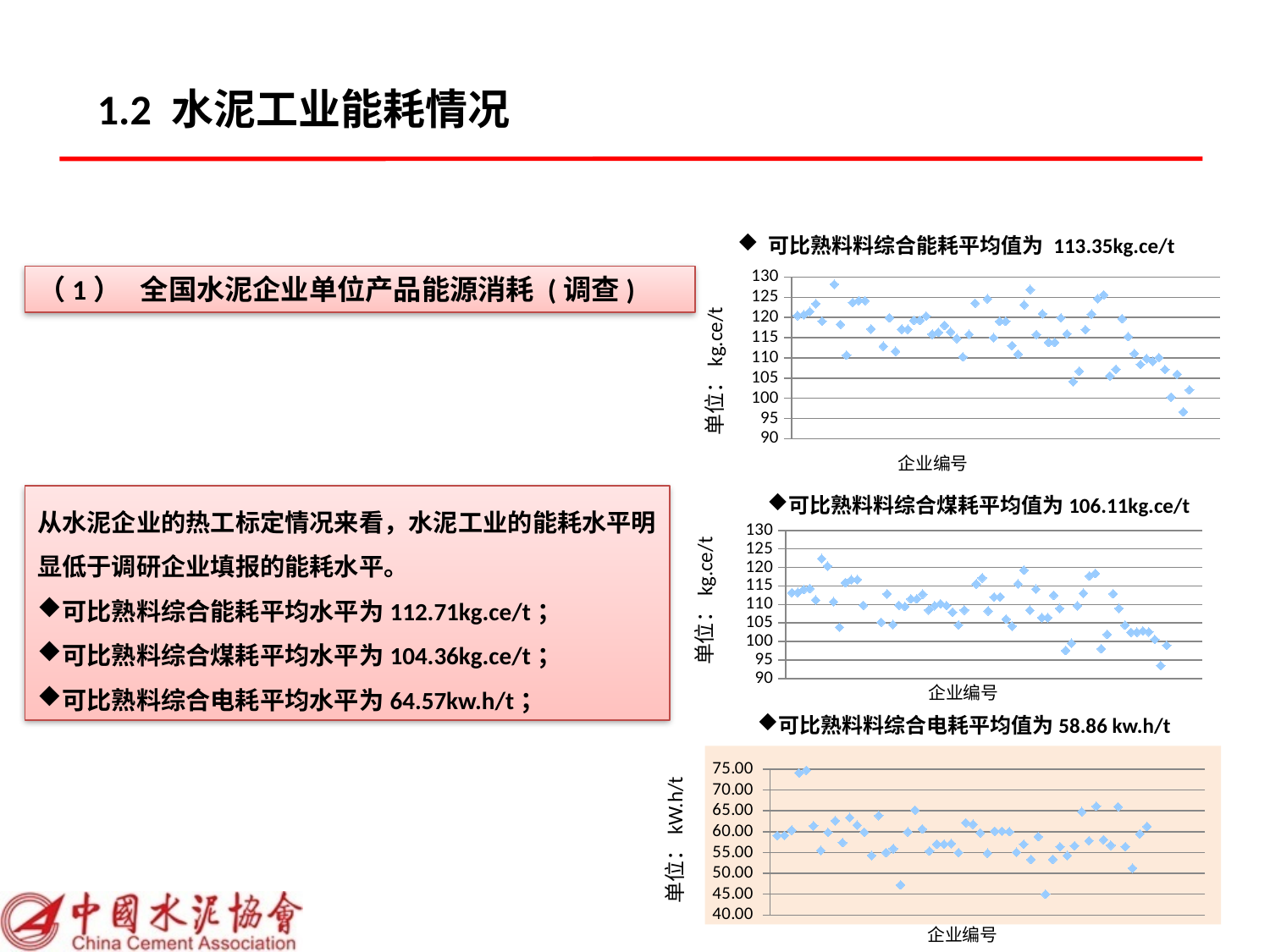
In the top chart (综合能耗), do the plotted values generally rise or fall from left to right along the x axis? fall In the bottom chart (综合电耗), is the highest plotted point greater or less than 70.00? greater What kind of chart is the top chart on the right (可比熟料料综合能耗平均值为 113.35kg.ce/t)? scatter chart In the top chart (综合能耗), is the highest plotted point greater or less than 125? greater In the middle chart (综合煤耗), is the highest plotted point greater or less than 120? greater According to the title of the top chart, what is the average comparable clinker comprehensive energy consumption (可比熟料料综合能耗平均值)? 113.35kg.ce/t According to the title of the bottom chart, what is the average comparable clinker comprehensive electricity consumption (可比熟料料综合电耗平均值)? 58.86 kw.h/t How many charts are shown on the slide? 3